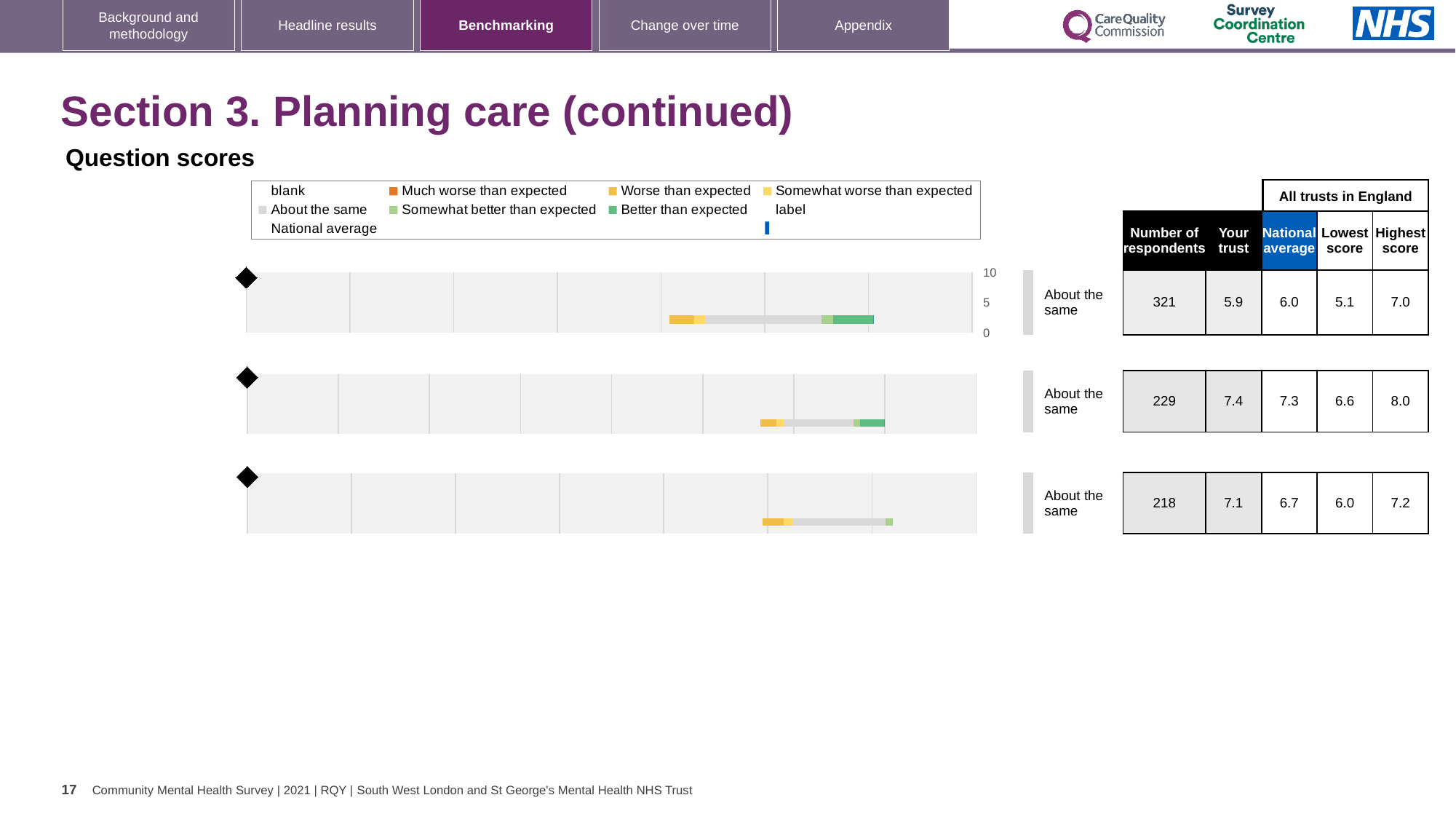
For the bottom chart, what is the difference between the 'Your trust' score and the national average? 0.4 In the legend, what does the orange colour represent? Much worse than expected For the middle chart, what is the difference between the highest score and the lowest score? 1.4 Which chart (top, middle or bottom) has the highest 'Your trust' score? middle Which chart (top, middle or bottom) has the lowest 'Lowest score' value? top For the top chart, what is the 'Your trust' score shown in the table? 5.9 For the bottom chart, how many respondents are listed? 218 For the top chart, which is larger: the 'Your trust' score or the national average? National average For the middle chart, what is the national average score? 7.3 What benchmark category label is shown next to each of the three charts? About the same How many question score charts are shown on the slide? 3 What kind of chart is used to show the question scores on this slide? bar chart